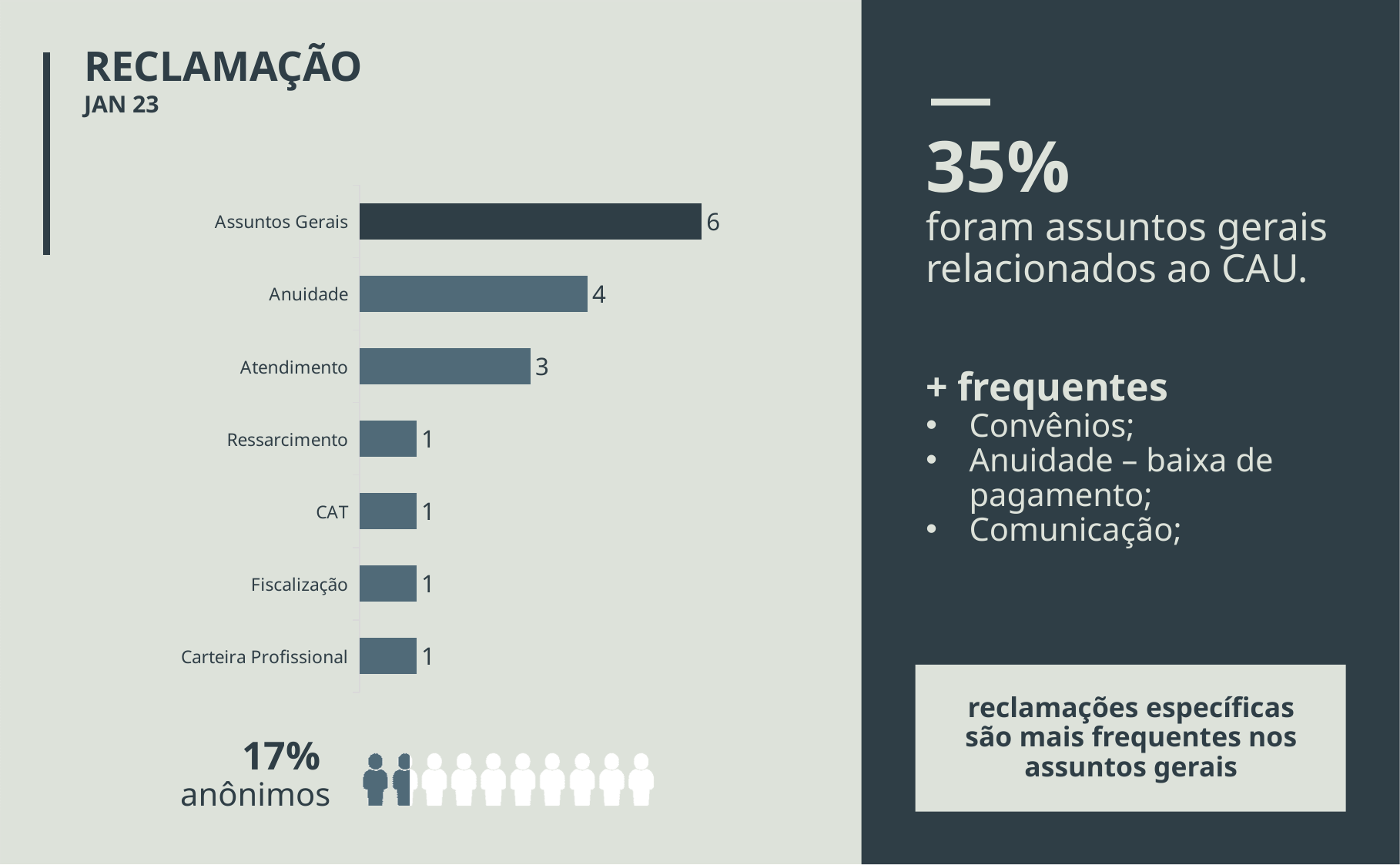
What is the title of the chart? RECLAMAÇÃO What is the value for Assuntos Gerais? 6 How many categories have a value of 1? 4 What is the value for Anuidade? 4 What kind of chart is shown on the slide? bar chart What is the value for Atendimento? 3 What is the value for Ressarcimento? 1 How many categories are shown in the chart? 7 Which category has the highest value? Assuntos Gerais Which is larger, the value for Atendimento or the value for CAT? Atendimento What is the difference between the values for Assuntos Gerais and Anuidade? 2 What is the difference between the values for Anuidade and Atendimento? 1